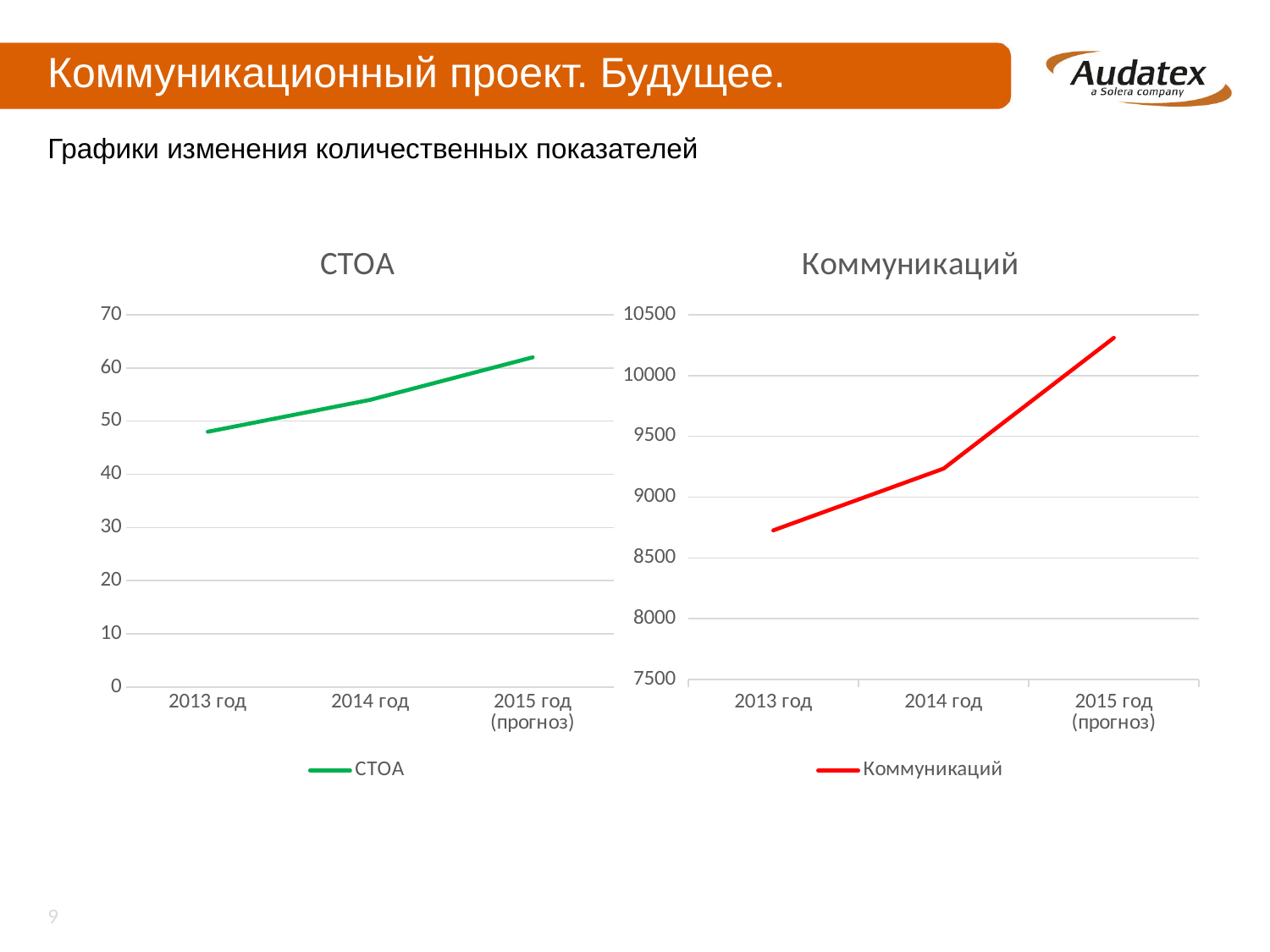
What kind of chart is the 'СТОА' chart? line chart In the 'Коммуникаций' chart, is the value for 2013 год greater or less than 9000? less In the 'Коммуникаций' chart, which is larger, the value for 2014 год or the value for 2013 год? 2014 год In the 'СТОА' chart, which year has the highest value? 2015 год (прогноз) How many data points are plotted in the 'Коммуникаций' chart? 3 In the 'Коммуникаций' chart, which year has the lowest value? 2013 год In the 'СТОА' chart, is the value for 2013 год greater or less than 50? less In the 'СТОА' chart, is the value for 2015 год (прогноз) greater or less than 60? greater In the 'Коммуникаций' chart, do the values rise or fall from 2013 год to 2015 год (прогноз)? rise In the 'СТОА' chart, do the values rise or fall along the x axis? rise How many series does the legend of the 'СТОА' chart list? 1